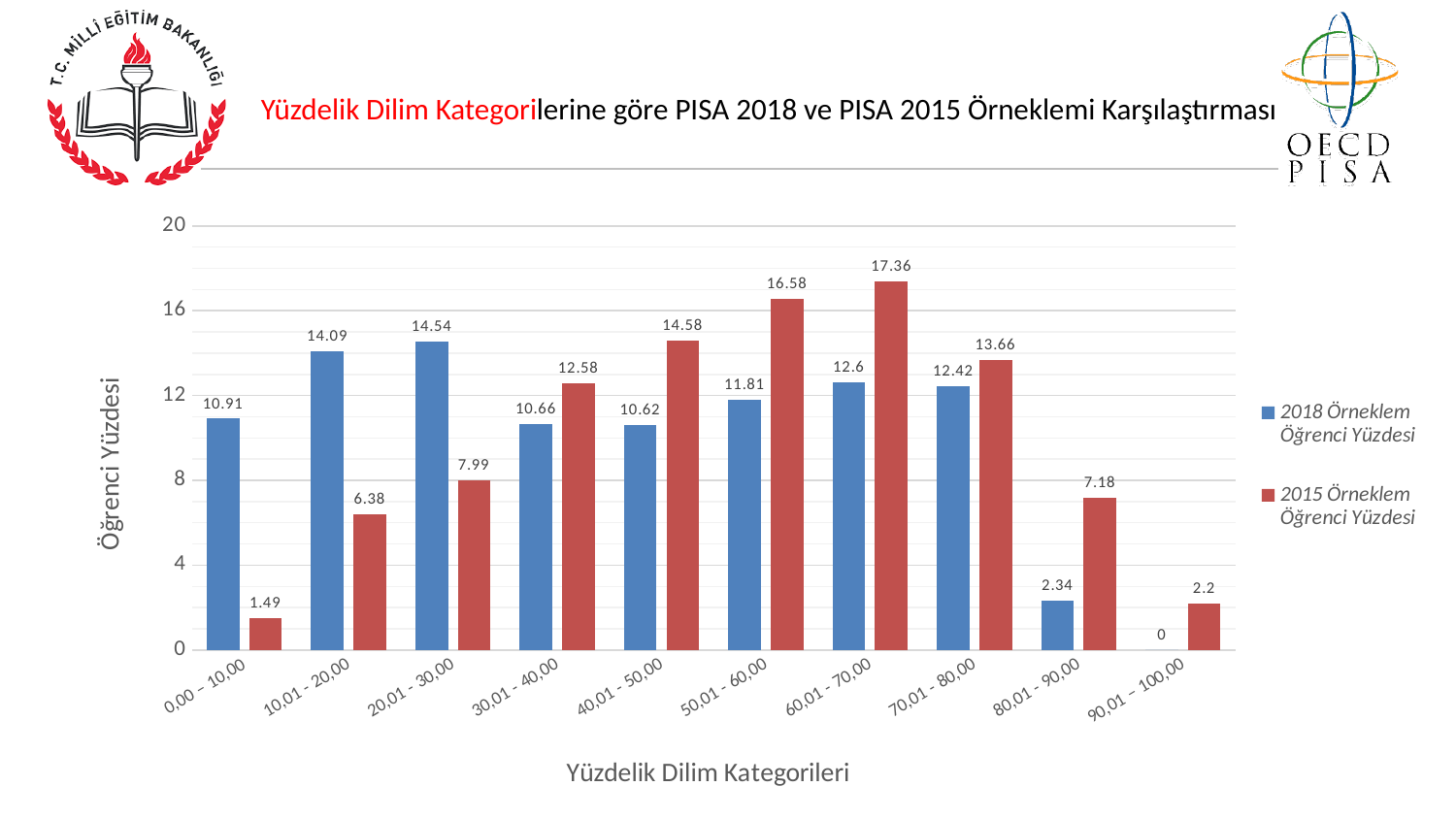
What is the 2015 Örneklem Öğrenci Yüzdesi value for the 90,01 – 100,00 category? 2.2 Which category has the lowest 2015 Örneklem Öğrenci Yüzdesi value? 0,00 – 10,00 How many series does the legend list? 2 What is the 2018 Örneklem Öğrenci Yüzdesi value for the 0,00 – 10,00 category? 10.91 What is the 2015 Örneklem Öğrenci Yüzdesi value for the 60,01 - 70,00 category? 17.36 What is the label of the y axis? Öğrenci Yüzdesi What kind of chart is shown on the slide? Bar chart How many categories are shown on the x axis? 10 What is the difference between the 2015 and 2018 values for the 50,01 - 60,00 category? 4.77 Is the 2015 Örneklem value for the 40,01 - 50,00 category greater or less than 12? greater For the 10,01 - 20,00 category, which series has the larger value, 2018 Örneklem or 2015 Örneklem? 2018 Örneklem Öğrenci Yüzdesi Which category has the highest 2018 Örneklem Öğrenci Yüzdesi value? 20,01 - 30,00